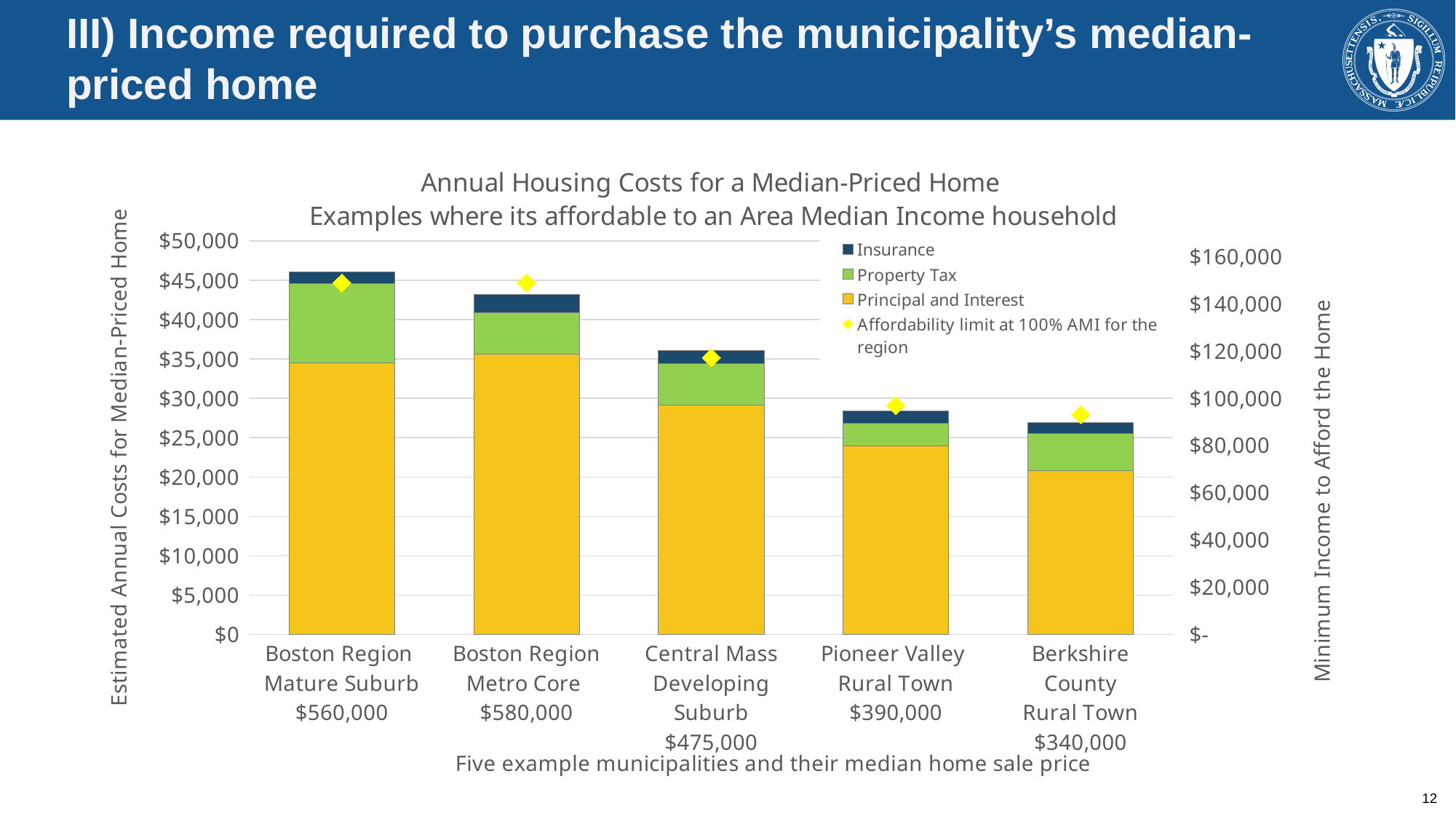
Which has the larger total annual housing cost, Boston Region Mature Suburb or Central Mass Developing Suburb? Boston Region Mature Suburb How many example municipalities are shown on the x axis? 5 How many entries does the legend list? 4 What kind of chart is shown on the slide? bar chart What is the median home sale price shown for Boston Region Metro Core? $580,000 Do the total annual housing costs rise or fall moving from left to right across the municipalities? fall Which municipality has the lowest median home sale price shown on the x axis? Berkshire County Rural Town Which legend entry is shown as yellow diamond markers? Affordability limit at 100% AMI for the region Which municipality has the highest total annual housing cost? Boston Region Mature Suburb Is the total annual housing cost for Pioneer Valley Rural Town greater or less than $30,000? less Is the Principal and Interest value for Berkshire County Rural Town greater or less than $25,000? less What is the difference between the median home sale prices of Boston Region Metro Core and Boston Region Mature Suburb? $20,000